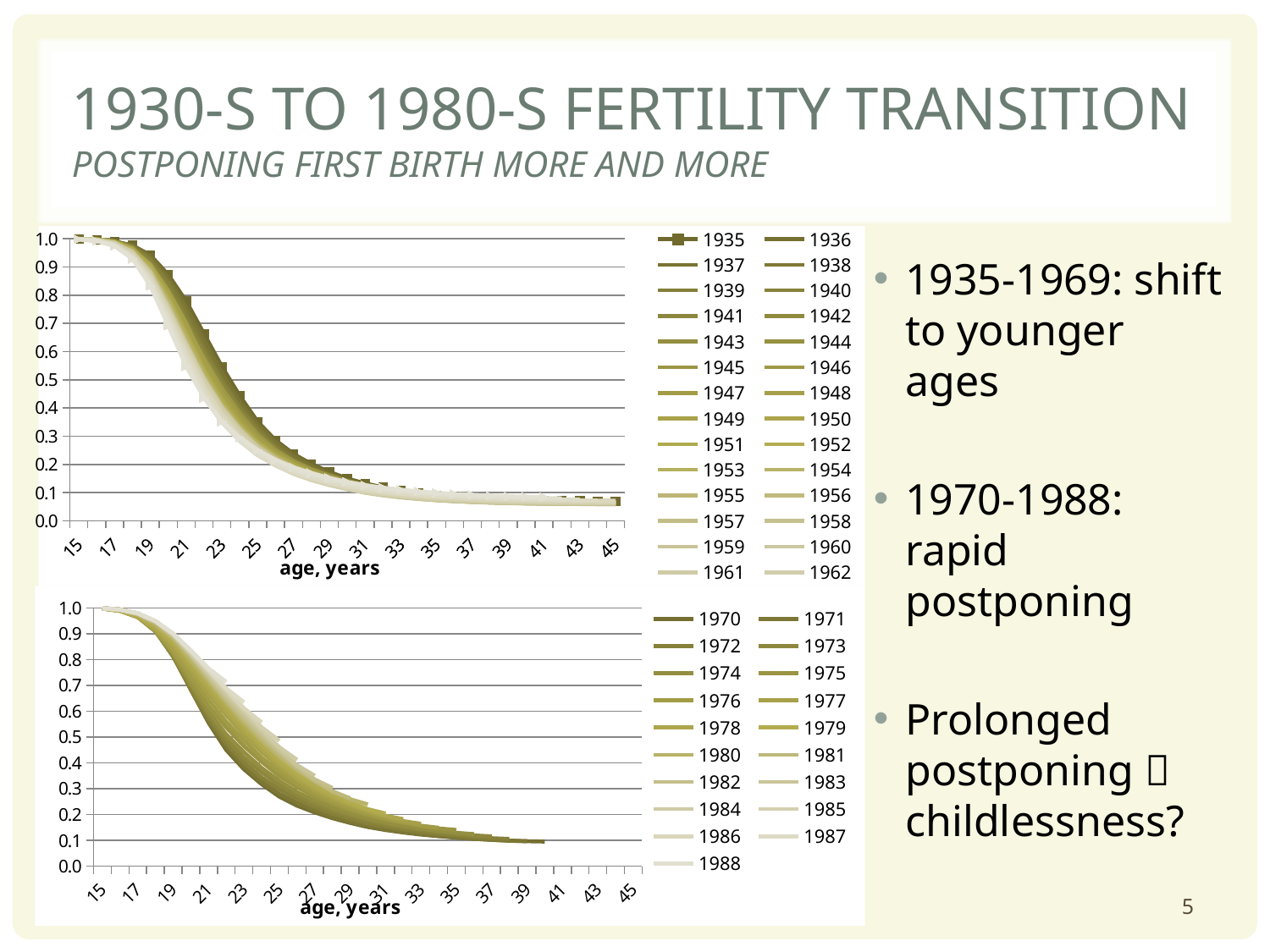
What is the last entry in the legend of the bottom chart? 1988 What kind of chart is the top chart on the slide? line chart In the bottom chart, do the values rise or fall as age increases along the x axis? fall What kind of chart is the bottom chart on the slide? line chart How many series does the legend of the top chart list? 28 In the top chart, do the values rise or fall as age increases along the x axis? fall In the bottom chart, is the value at age 39 greater or less than 0.2? less In the bottom chart, is the value at age 21 greater or less than 0.4? greater In the top chart, is the value at age 45 greater or less than 0.2? less What is the x-axis label of the top chart? age, years How many series does the legend of the bottom chart list? 19